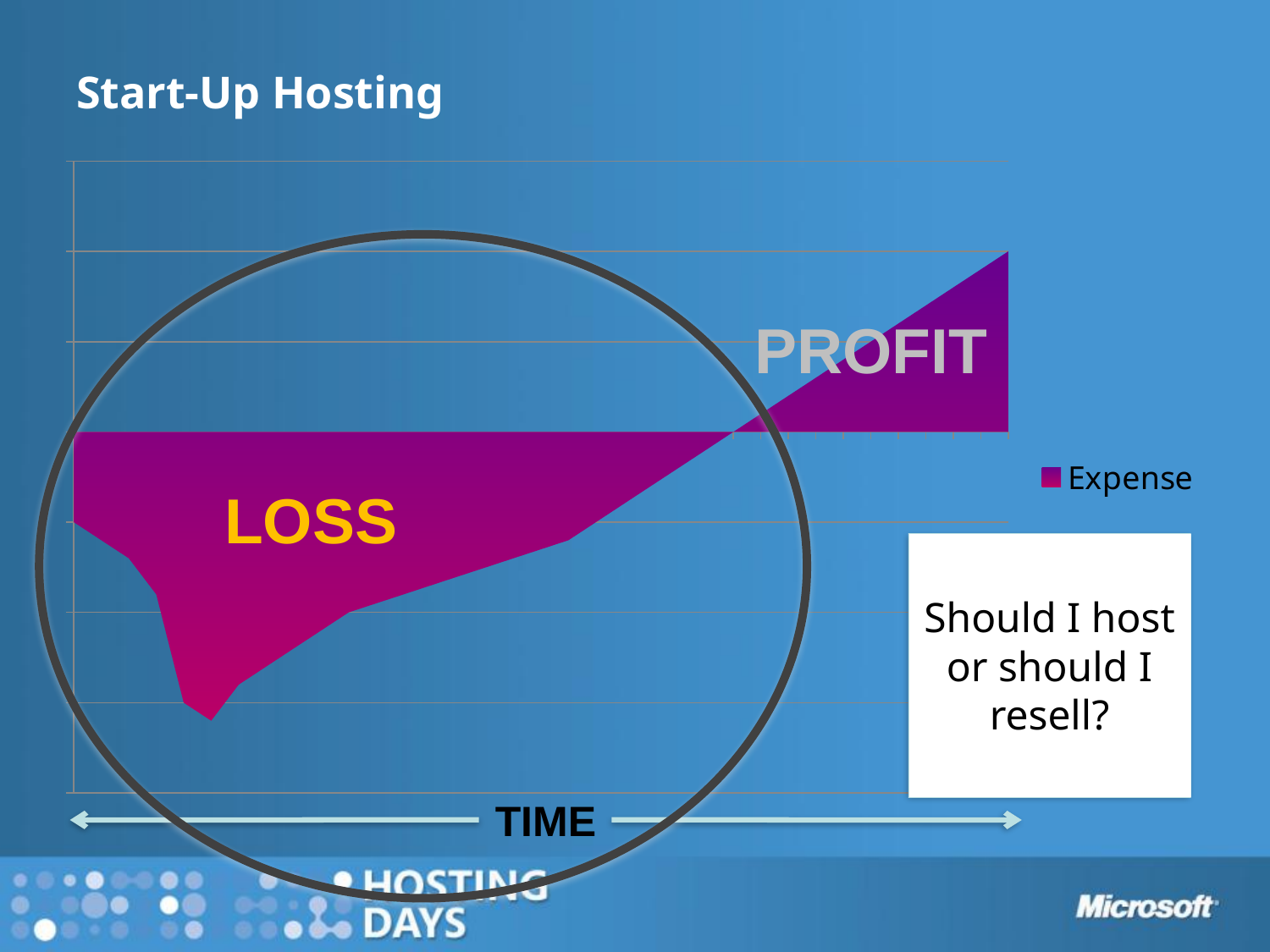
What is the name of the series listed in the chart's legend? Expense Does the chart end in the region labelled LOSS or the region labelled PROFIT at the right end of the time axis? PROFIT Over time, does the Expense series on the chart generally rise or fall after its initial dip? rise Is the Expense series above or below the horizontal axis at the start of the time axis? below What label is shown along the chart's horizontal axis? TIME How many series does the chart's legend list? 1 What kind of chart is shown on the slide? area chart